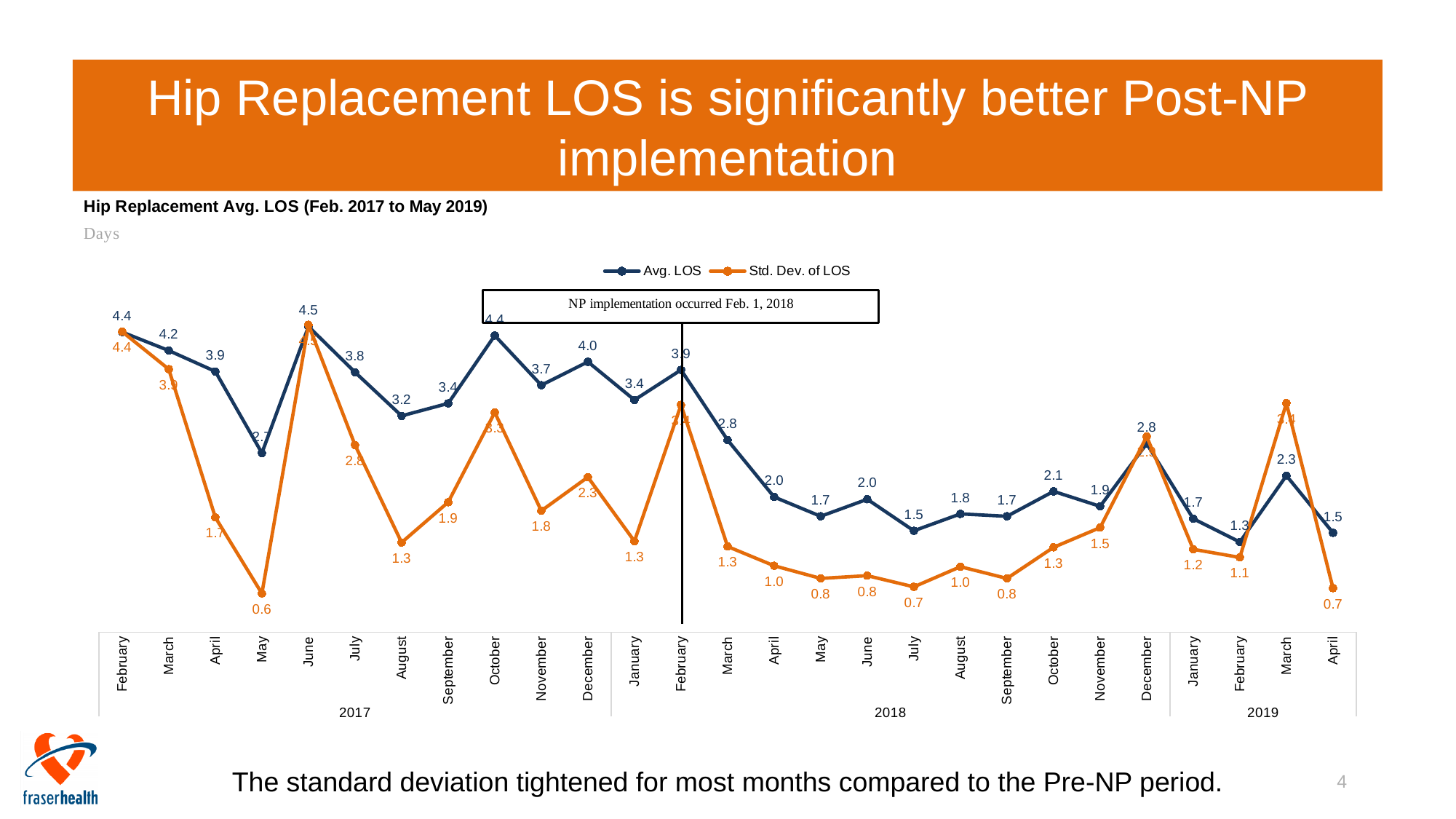
Does the Avg. LOS rise or fall from February 2018 to April 2018? Fall What is the Avg. LOS for February 2019? 1.3 Which month has the lowest Std. Dev. of LOS? May 2017 What is the difference between the Avg. LOS in February 2017 and February 2019? 3.1 Which is larger, the Avg. LOS in October 2017 or October 2018? October 2017 What is the Std. Dev. of LOS for May 2017? 0.6 Which month has the highest Avg. LOS? June 2017 How many series does the legend list? 2 How many monthly data points are plotted for each series? 27 What is the Avg. LOS for June 2017? 4.5 What kind of chart is shown on the slide? Line chart According to the annotation on the chart, when did NP implementation occur? Feb. 1, 2018